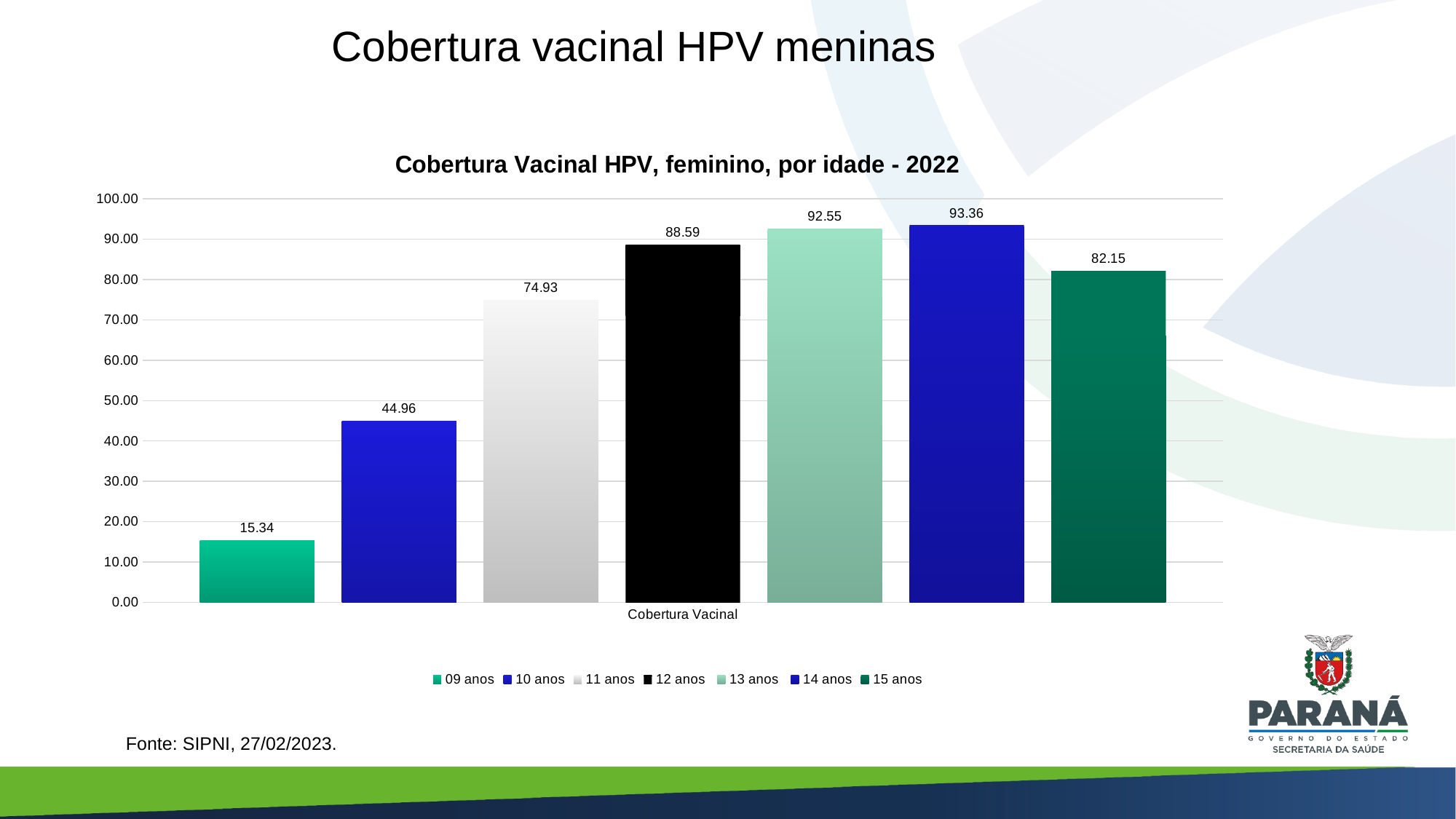
Which is larger, the coverage for 11 anos or for 10 anos? 11 anos What is the vaccination coverage value for 09 anos? 15.34 Is the value for 10 anos greater or less than 50.00? less What is the difference between the coverage for 13 anos and 15 anos? 10.40 Which age group has the highest vaccination coverage? 14 anos What is the difference between the coverage for 14 anos and 09 anos? 78.02 What is the vaccination coverage value for 15 anos? 82.15 What is the title of the chart? Cobertura Vacinal HPV, feminino, por idade - 2022 How many series does the legend list? 7 What kind of chart is shown on the slide? bar chart Which age group has the lowest vaccination coverage? 09 anos What is the vaccination coverage value for 12 anos? 88.59